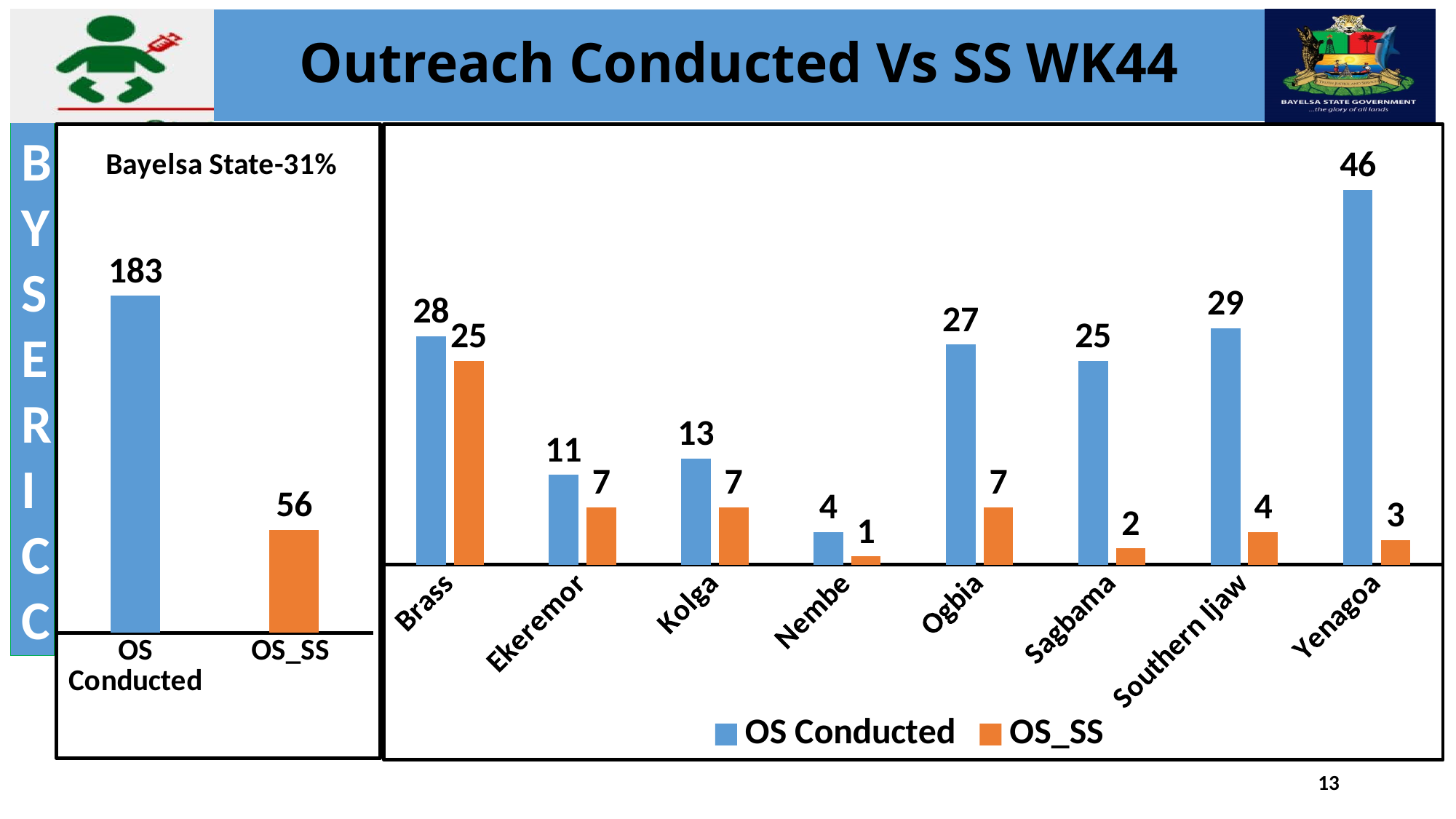
In the right chart, what is the OS Conducted value for Yenagoa? 46 In the left chart titled 'Bayelsa State-31%', what is the value for OS_SS? 56 In the right chart, what is the difference between OS Conducted and OS_SS for Southern Ijaw? 25 In the right chart, which LGA has the highest OS Conducted value? Yenagoa In the right chart, how many series does the legend list? 2 What type of chart is the right chart? Bar chart In the right chart, which LGA has the lowest OS_SS value? Nembe In the left chart titled 'Bayelsa State-31%', what is the value for OS Conducted? 183 In the right chart, how many LGAs are shown on the x axis? 8 In the right chart, which is larger: the OS Conducted value for Ogbia or for Sagbama? Ogbia In the left chart titled 'Bayelsa State-31%', what is the difference between OS Conducted and OS_SS? 127 In the right chart, what is the OS_SS value for Brass? 25